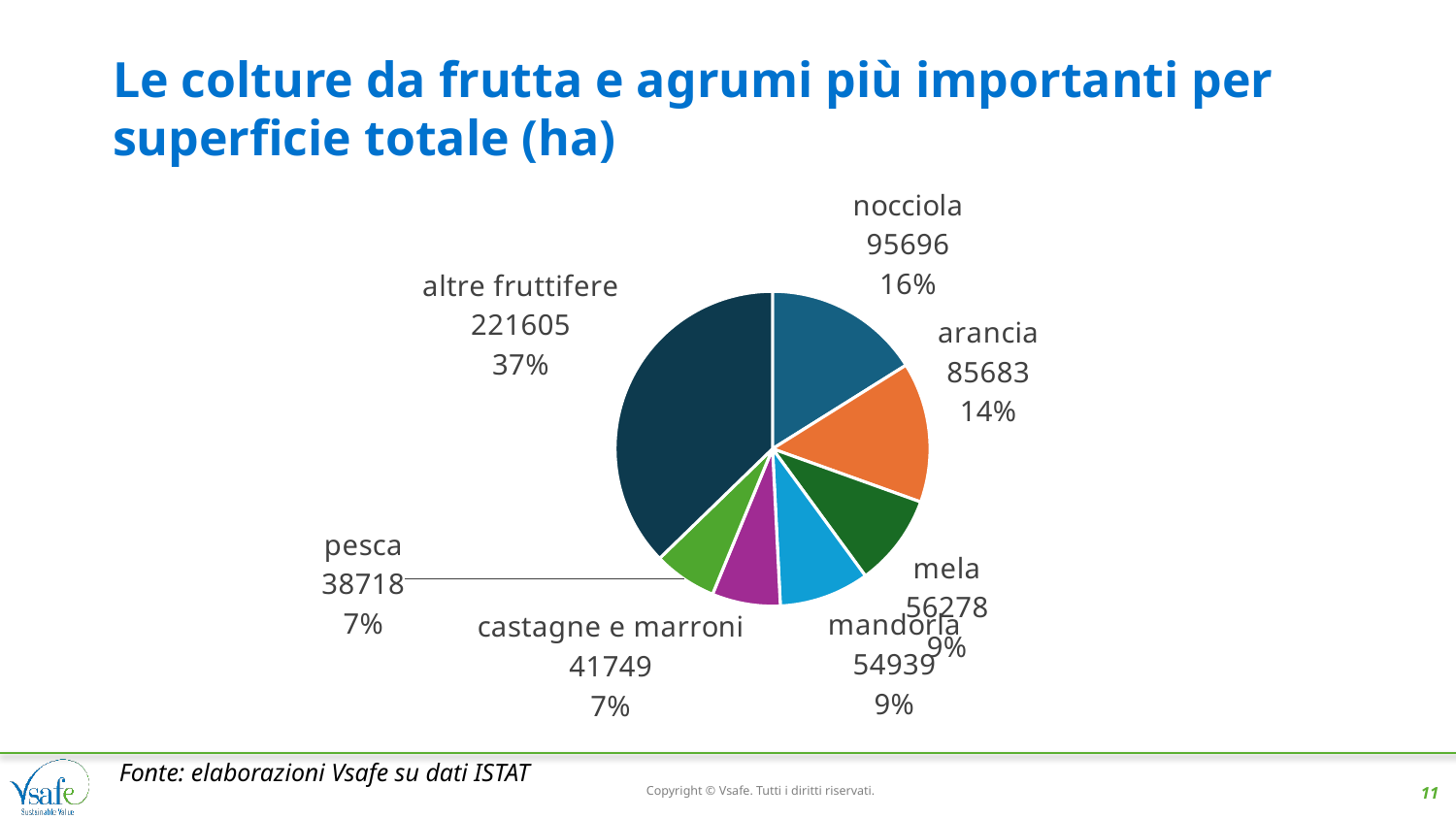
Which category has the smallest slice of the pie? pesca What kind of chart is shown on the slide? pie chart Which category has the largest slice of the pie? altre fruttifere What is the title of the chart on the slide? Le colture da frutta e agrumi più importanti per superficie totale (ha) How many slices does the pie chart have? 7 Which is larger, the value for nocciola or the value for mela? nocciola What is the surface area value shown for nocciola? 95696 What percentage share of the pie does altre fruttifere have? 37% What is the difference between the values for nocciola and arancia? 10013 What is the value shown for castagne e marroni? 41749 What is the value shown for arancia? 85683 What percentage share of the pie does pesca have? 7%